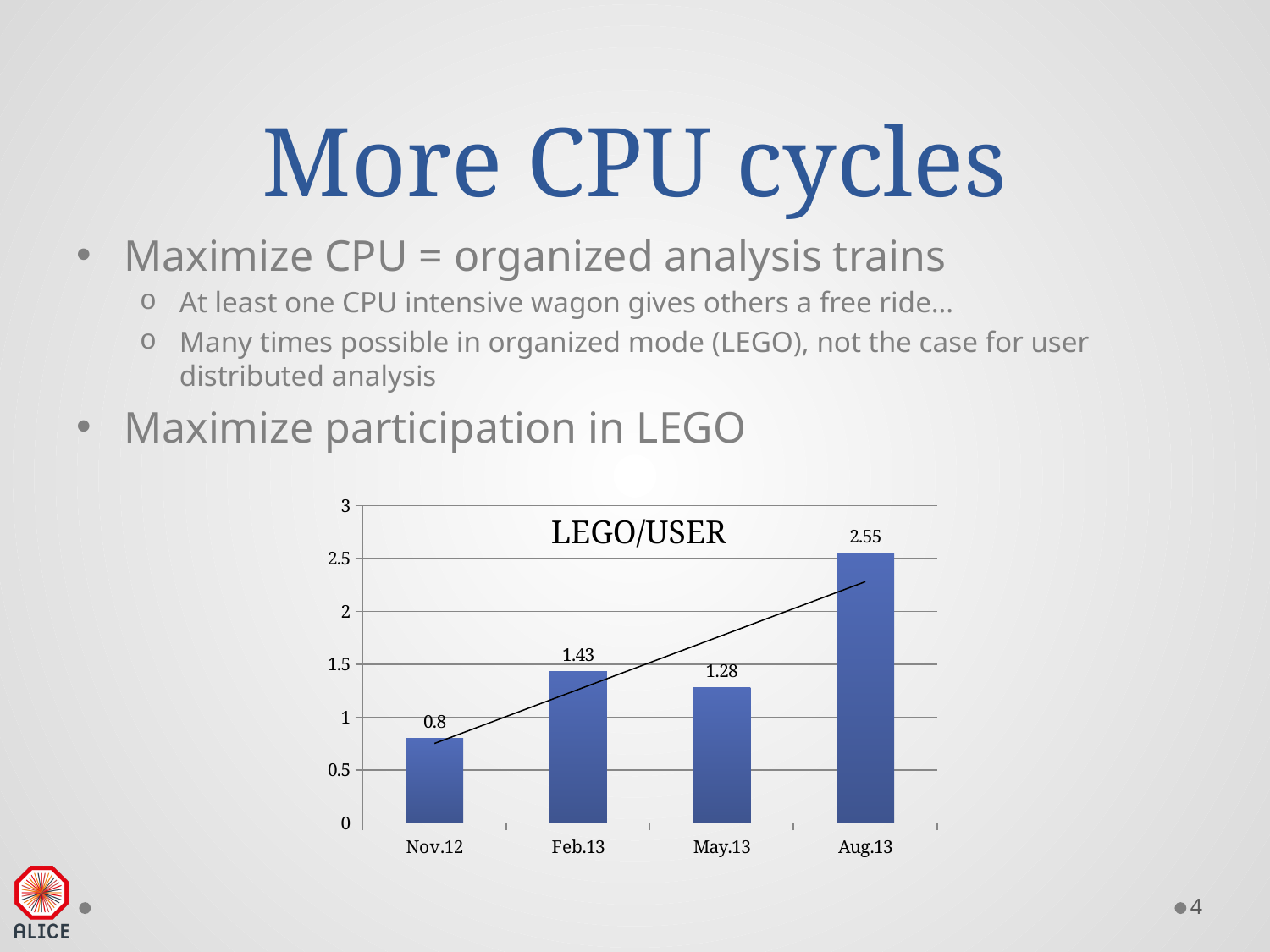
What is the LEGO/USER value for Aug.13? 2.55 Which period has the lowest LEGO/USER value? Nov.12 Which is larger, the LEGO/USER value for Feb.13 or for May.13? Feb.13 What is the title of the chart? LEGO/USER How many periods are shown on the x axis of the chart? 4 What is the LEGO/USER value for Nov.12? 0.8 What is the difference between the LEGO/USER values for Aug.13 and Nov.12? 1.75 What is the LEGO/USER value for May.13? 1.28 Which period has the highest LEGO/USER value? Aug.13 What is the LEGO/USER value for Feb.13? 1.43 Is the LEGO/USER value for Aug.13 greater or less than 2? greater What kind of chart is shown on the slide? bar chart